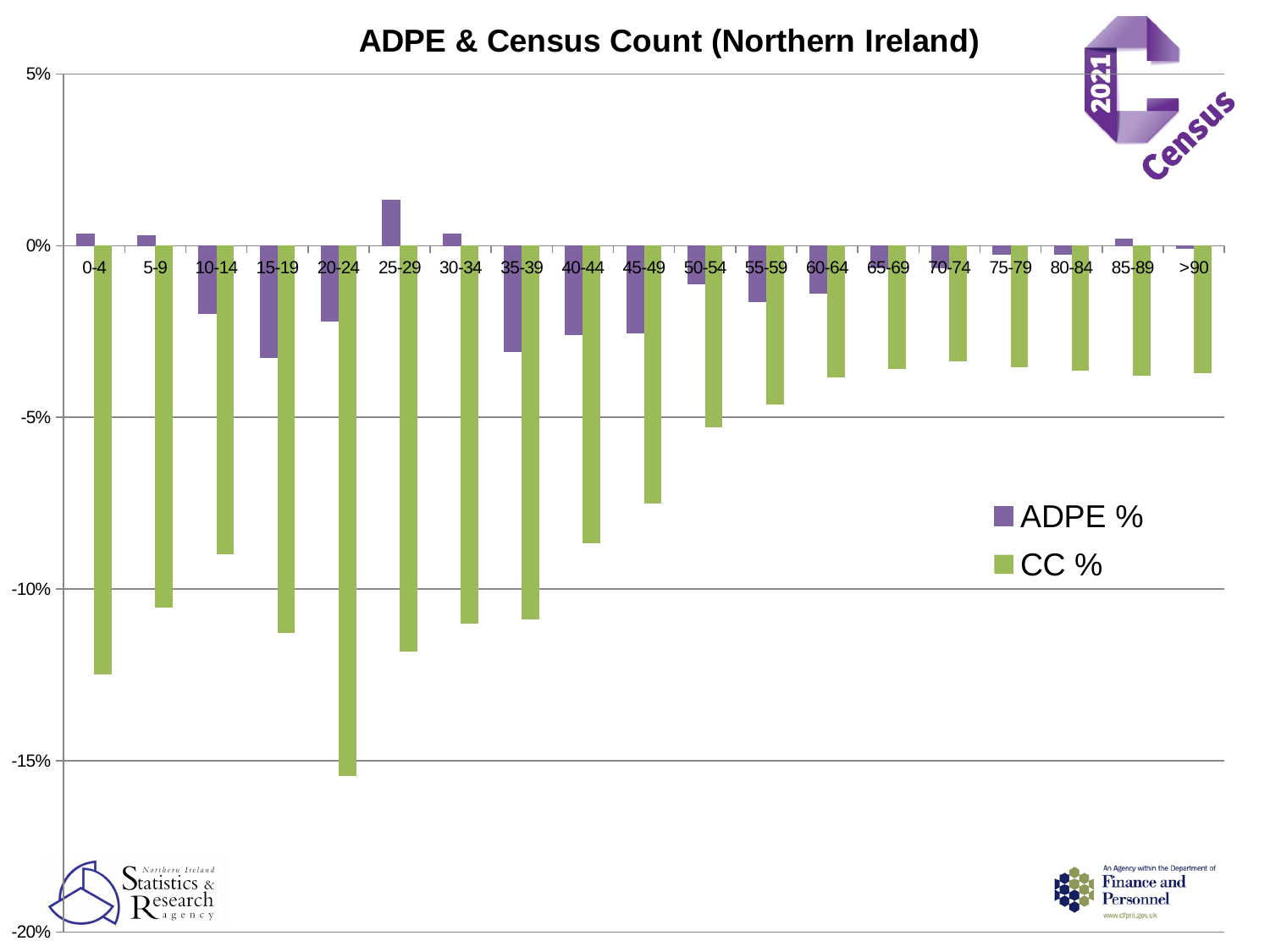
Is the CC % value for 0-4 greater or less than -10%? less Is the CC % value for 20-24 greater or less than -15%? less Do the CC % values rise or fall from 20-24 through 55-59? rise Which age group has the highest ADPE % value? 25-29 Is the ADPE % value for 25-29 greater or less than 0%? greater How many series does the legend list? 2 Which series is drawn in green? CC % Which age group has the lowest CC % value? 20-24 What is the title of the chart? ADPE & Census Count (Northern Ireland) How many age-group categories are shown on the x axis? 19 What kind of chart is shown on the slide? bar chart Which is larger, the CC % value for 0-4 or for 5-9? 5-9